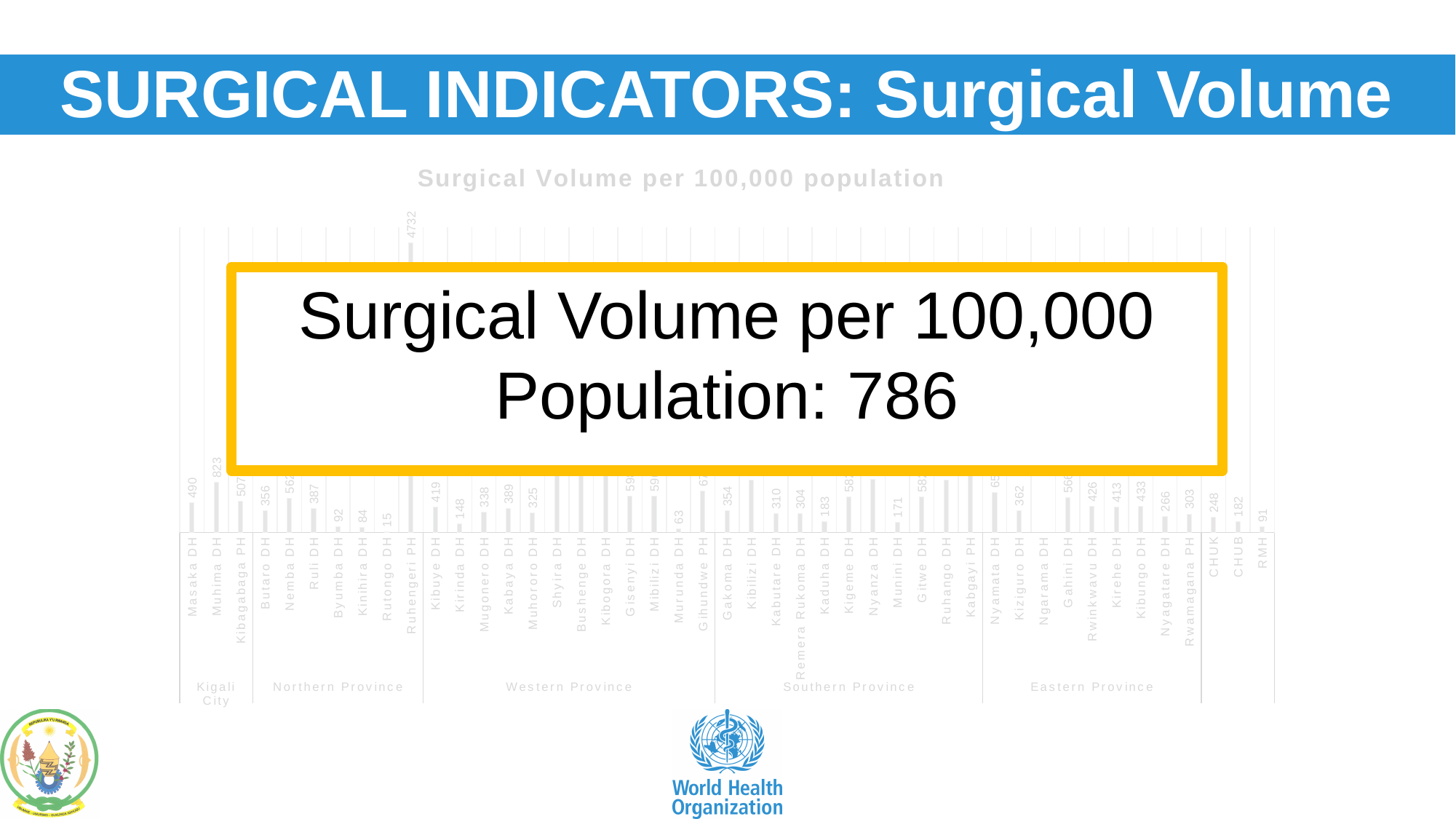
Which facility has the lowest surgical volume per 100,000 population? Rutongo DH What is the title of the chart? Surgical Volume per 100,000 population Which facility has the highest surgical volume per 100,000 population? Ruhengeri PH What is the value shown for Masaka DH? 490 What is the surgical volume per 100,000 population for Muhima DH? 823 Which has a higher value, Kibuye DH or Kirinda DH? Kibuye DH What is the value shown for Nyagatare DH? 266 What is the value shown for CHUK? 248 Which has a higher value, Nemba DH or Butaro DH? Nemba DH What type of chart is shown on the slide? bar chart What is the value shown for Ruhengeri PH? 4732 What is the difference between the values for Muhima DH and Masaka DH? 333